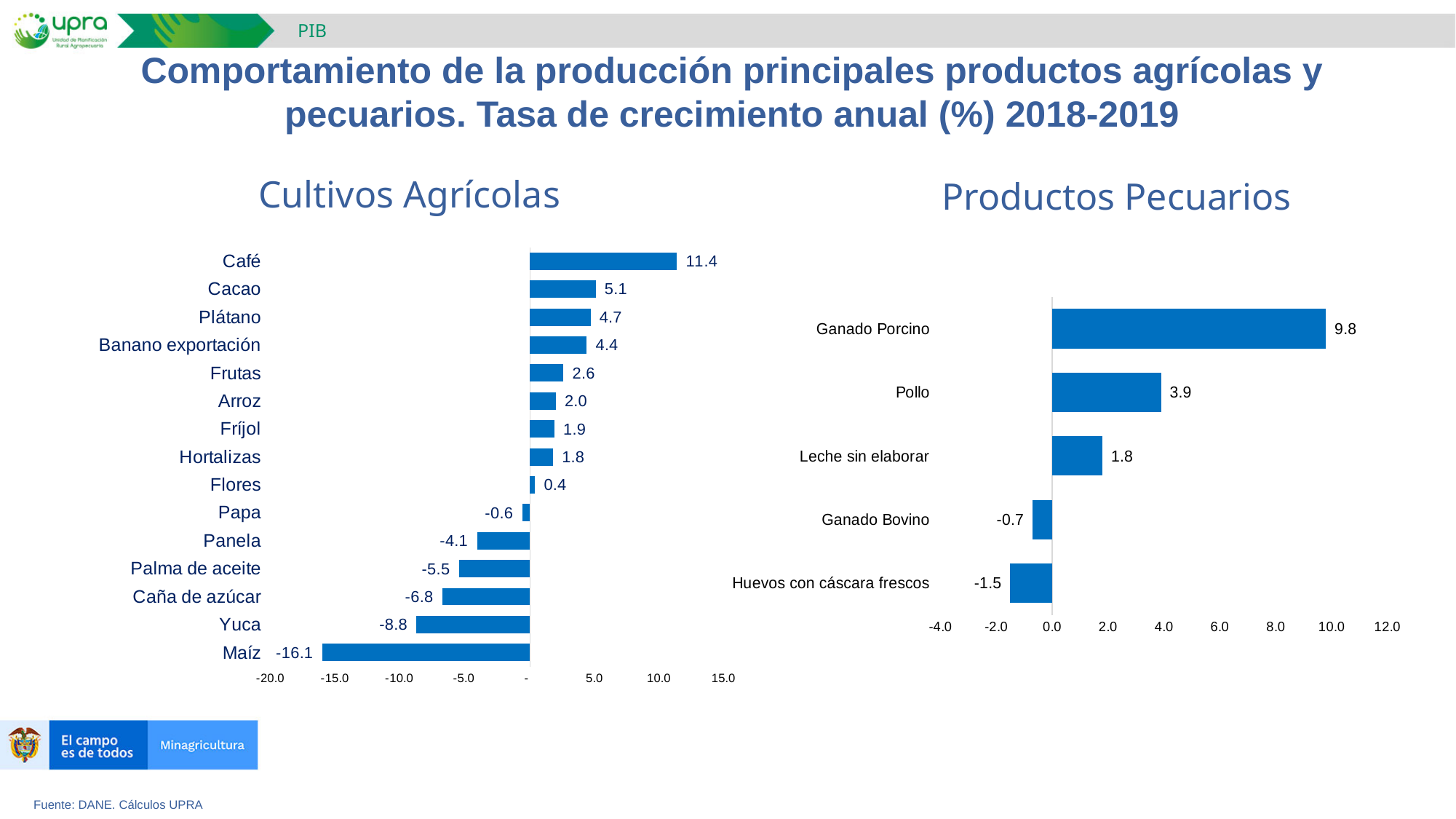
In the Productos Pecuarios chart, which category has the highest value? Ganado Porcino In the Cultivos Agrícolas chart, what is the value for Café? 11.4 In the Productos Pecuarios chart, how many categories are shown? 5 What kind of chart is the Productos Pecuarios chart? Bar chart In the Cultivos Agrícolas chart, which category has the highest value? Café In the Cultivos Agrícolas chart, how many categories are shown? 15 In the Productos Pecuarios chart, what is the value for Pollo? 3.9 In the Productos Pecuarios chart, which category has the lowest value? Huevos con cáscara frescos In the Cultivos Agrícolas chart, what is the value for Maíz? -16.1 In the Cultivos Agrícolas chart, which is larger, the value for Plátano or the value for Frutas? Plátano In the Cultivos Agrícolas chart, what is the difference between the values for Café and Cacao? 6.3 In the Cultivos Agrícolas chart, which category has the lowest value? Maíz